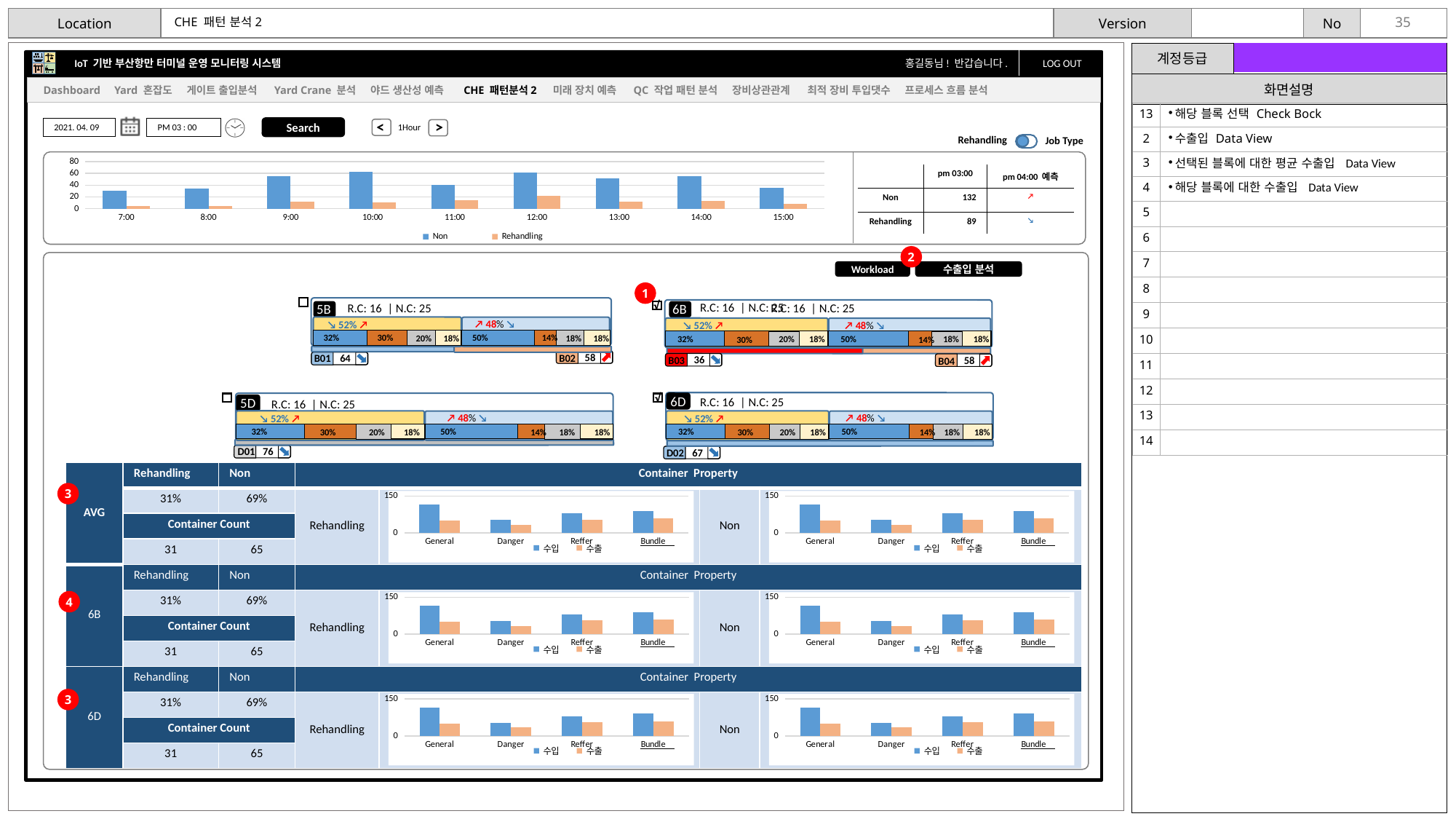
In the top hourly chart, at which hour is the Rehandling bar highest? 12:00 In the top hourly chart, is the Non value at 7:00 greater or less than 40? less In the top hourly chart, which colour represents the Rehandling series in the legend? orange In the top hourly chart, is the Rehandling value at 7:00 greater or less than 20? less In the top hourly chart, which is larger at 12:00, Non or Rehandling? Non In the top hourly chart, is the Non value at 10:00 greater or less than 40? greater What kind of chart is the hourly chart at the top of the dashboard (7:00 to 15:00)? bar chart In the AVG row's Rehandling Container Property chart, which category has the tallest 수입 bar? General How many series does the legend of the top hourly chart list? 2 How many hourly categories are shown on the x axis of the top chart (7:00 to 15:00)? 9 In the top hourly chart, which Non bar is taller, 9:00 or 11:00? 9:00 In the AVG row's Rehandling Container Property chart, how many categories are shown on the x axis? 4